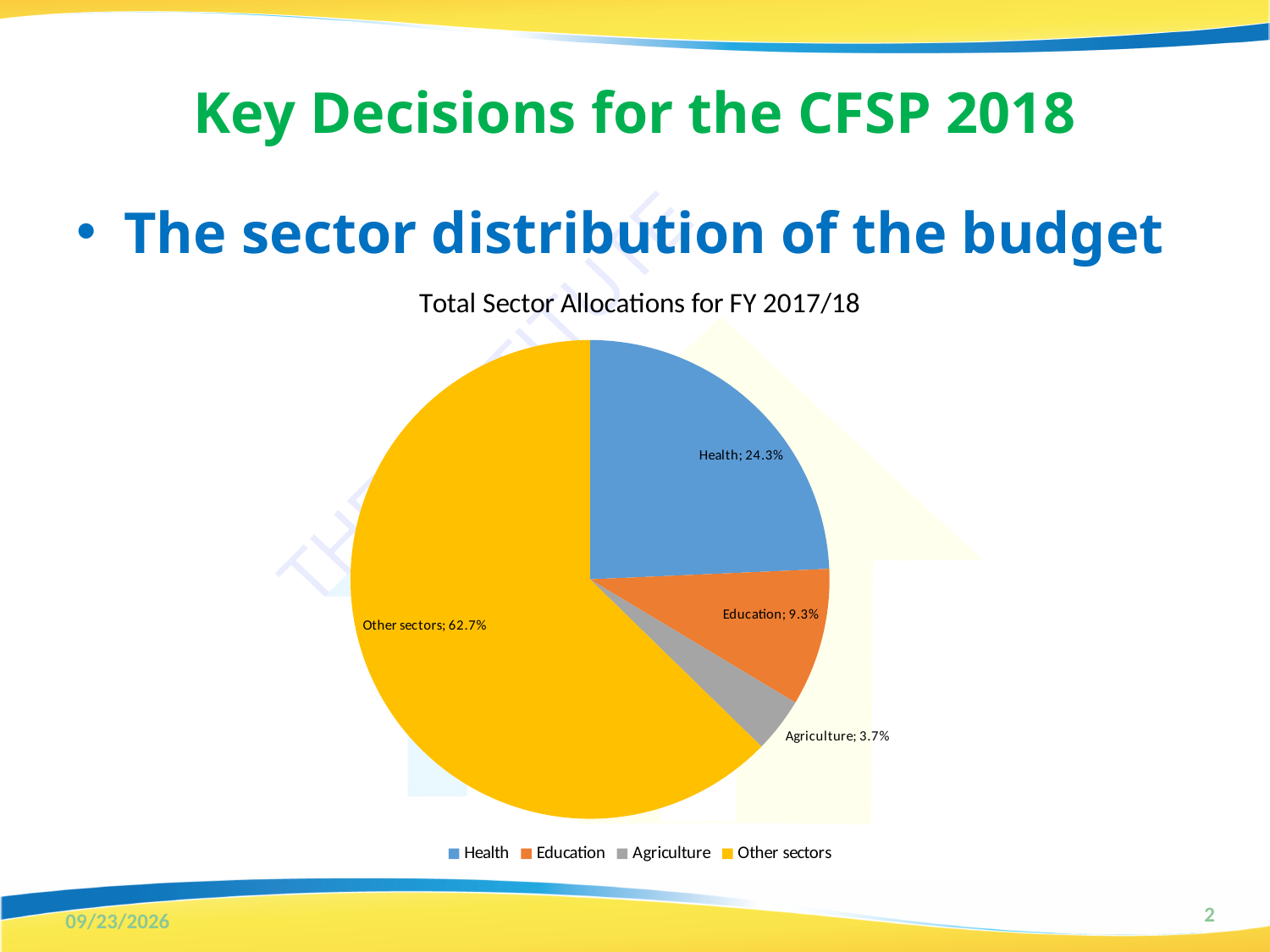
How many entries does the legend list? 4 Which sector has the smallest share of the budget? Agriculture What is the difference in percentage points between the Health and Education shares? 15.0 percentage points What share of the budget is allocated to Health? 24.3% How many slices does the pie chart have? 4 What share of the budget is allocated to Other sectors? 62.7% What share of the budget is allocated to Education? 9.3% What share of the budget is allocated to Agriculture? 3.7% What is the title of the chart? Total Sector Allocations for FY 2017/18 What type of chart is shown on the slide? pie chart Which sector has the largest share of the budget? Other sectors Which has a larger share, Education or Agriculture? Education